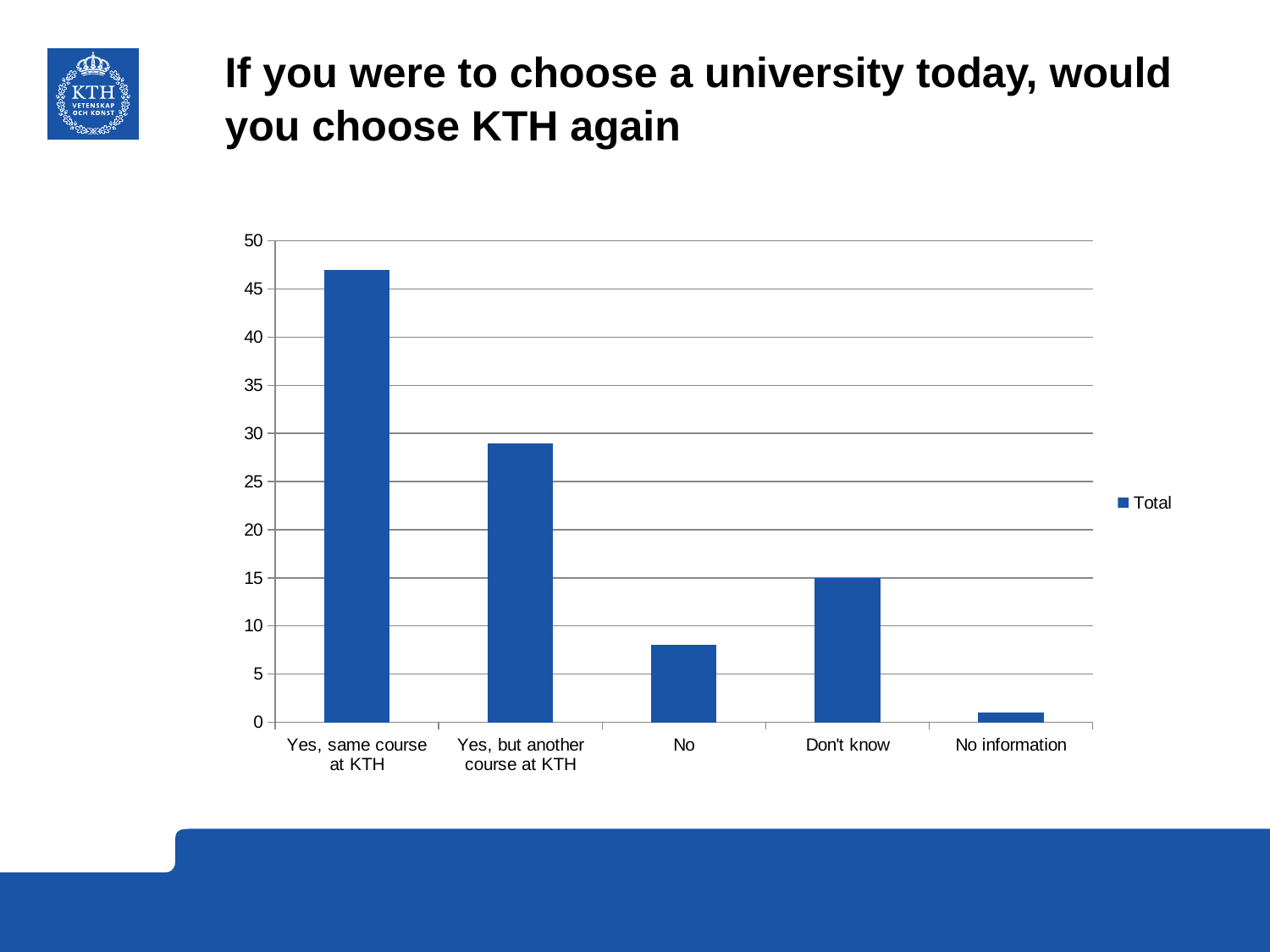
Which category has the lowest bar? No information Is the value for "No information" greater or less than 5? less How many series does the legend list? 1 Is the value for "No" greater or less than 10? less What kind of chart is shown on the slide? bar chart What is the name of the series shown in the legend? Total How many categories are shown on the x axis of the chart? 5 Is the value for "Yes, same course at KTH" greater or less than 45? greater Which is larger, the value for "Yes, same course at KTH" or the value for "Yes, but another course at KTH"? Yes, same course at KTH Which category has the highest bar? Yes, same course at KTH Which is larger, the value for "No" or the value for "Don't know"? Don't know